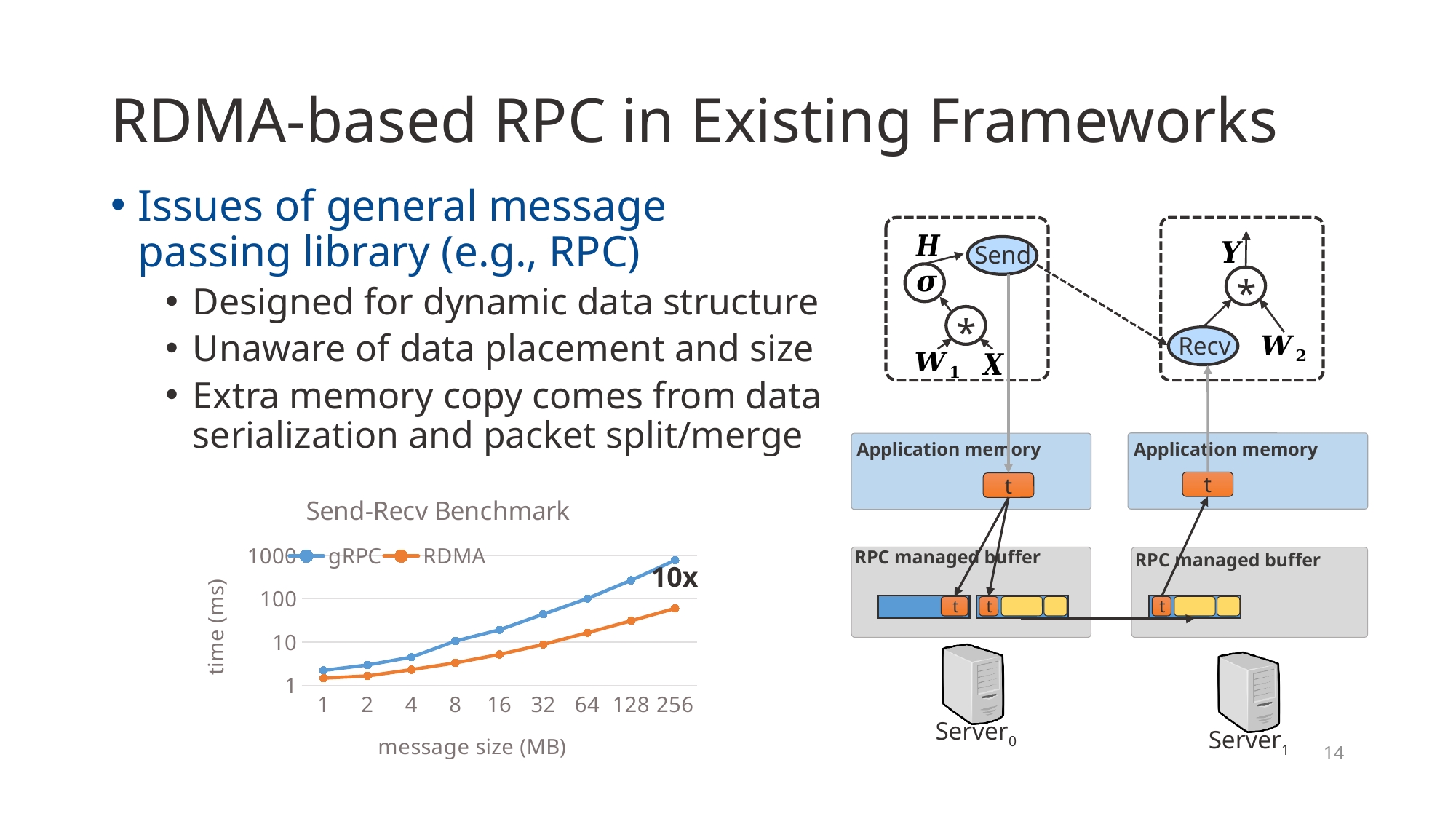
What kind of chart is the Send-Recv Benchmark? line chart In the Send-Recv Benchmark chart, is the gRPC time at 256 MB greater or less than 100 ms? greater In the Send-Recv Benchmark chart, is the RDMA time at 16 MB greater or less than 10 ms? less In the Send-Recv Benchmark chart, is the gRPC time at 16 MB greater or less than 10 ms? greater In the Send-Recv Benchmark chart, which series has the larger time at a message size of 256 MB, gRPC or RDMA? gRPC How many message sizes are plotted along the x axis of the Send-Recv Benchmark chart? 9 What is the label of the y axis of the Send-Recv Benchmark chart? time (ms) What is the title of the chart on the slide? Send-Recv Benchmark How many series does the legend of the Send-Recv Benchmark chart list? 2 In the Send-Recv Benchmark chart, does the gRPC time rise or fall as message size increases? rise In the Send-Recv Benchmark chart, at which message size is the RDMA time highest? 256